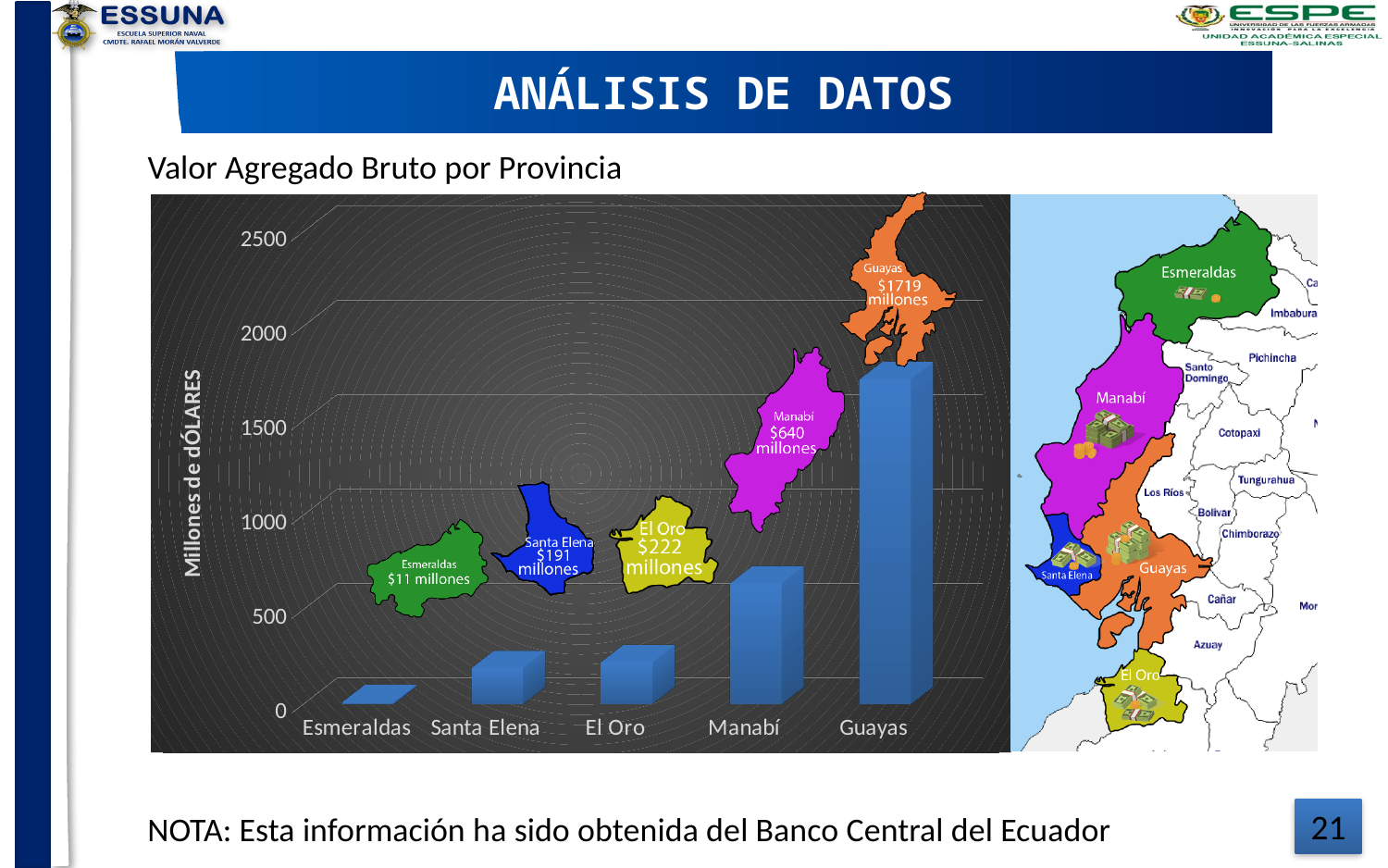
Is the value for Guayas greater or less than 1500 on the y axis? greater How many provinces are shown on the x axis of the chart? 5 Which province has the lowest Valor Agregado Bruto in the chart? Esmeraldas Which has a larger Valor Agregado Bruto, Manabí or El Oro? Manabí What is the Valor Agregado Bruto for Esmeraldas as labelled on the slide? $11 millones What is the label of the y axis of the chart? Millones de dÓLARES What is the difference between the Valor Agregado Bruto of Guayas and Manabí, in millones? 1079 What is the Valor Agregado Bruto for Guayas as labelled on the slide? $1719 millones Which province has the highest Valor Agregado Bruto in the chart? Guayas What kind of chart is used to show Valor Agregado Bruto por Provincia? bar chart What is the Valor Agregado Bruto for Manabí as labelled on the slide? $640 millones What is the Valor Agregado Bruto for Santa Elena as labelled on the slide? $191 millones